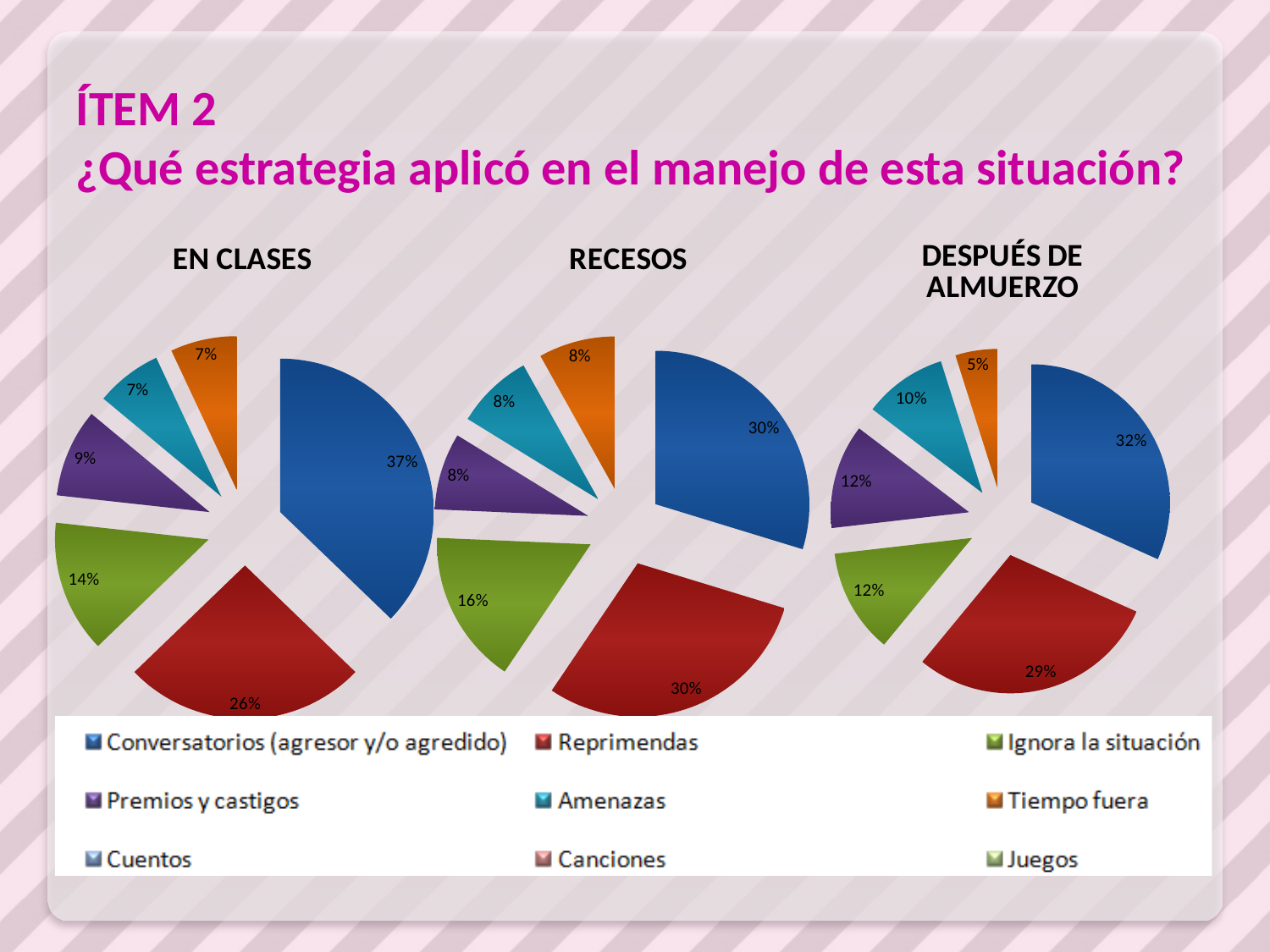
In the RECESOS chart, what share is shown for Ignora la situación? 16% In the DESPUÉS DE ALMUERZO chart, what share is shown for Tiempo fuera? 5% In the EN CLASES chart, which strategy has the largest share? Conversatorios (agresor y/o agredido) How many pie charts are shown on the slide? 3 How many entries does the shared legend list? 9 In the DESPUÉS DE ALMUERZO chart, what share is shown for Amenazas? 10% In the DESPUÉS DE ALMUERZO chart, which strategy has the smallest share? Tiempo fuera In the EN CLASES chart, what is the difference between the shares for Conversatorios (agresor y/o agredido) and Reprimendas? 11% In the EN CLASES chart, what share is shown for Conversatorios (agresor y/o agredido)? 37% In the EN CLASES chart, what share is shown for Reprimendas? 26% In the RECESOS chart, which is larger, the share for Ignora la situación or the share for Premios y castigos? Ignora la situación What kind of chart is used for EN CLASES, RECESOS and DESPUÉS DE ALMUERZO? Pie chart